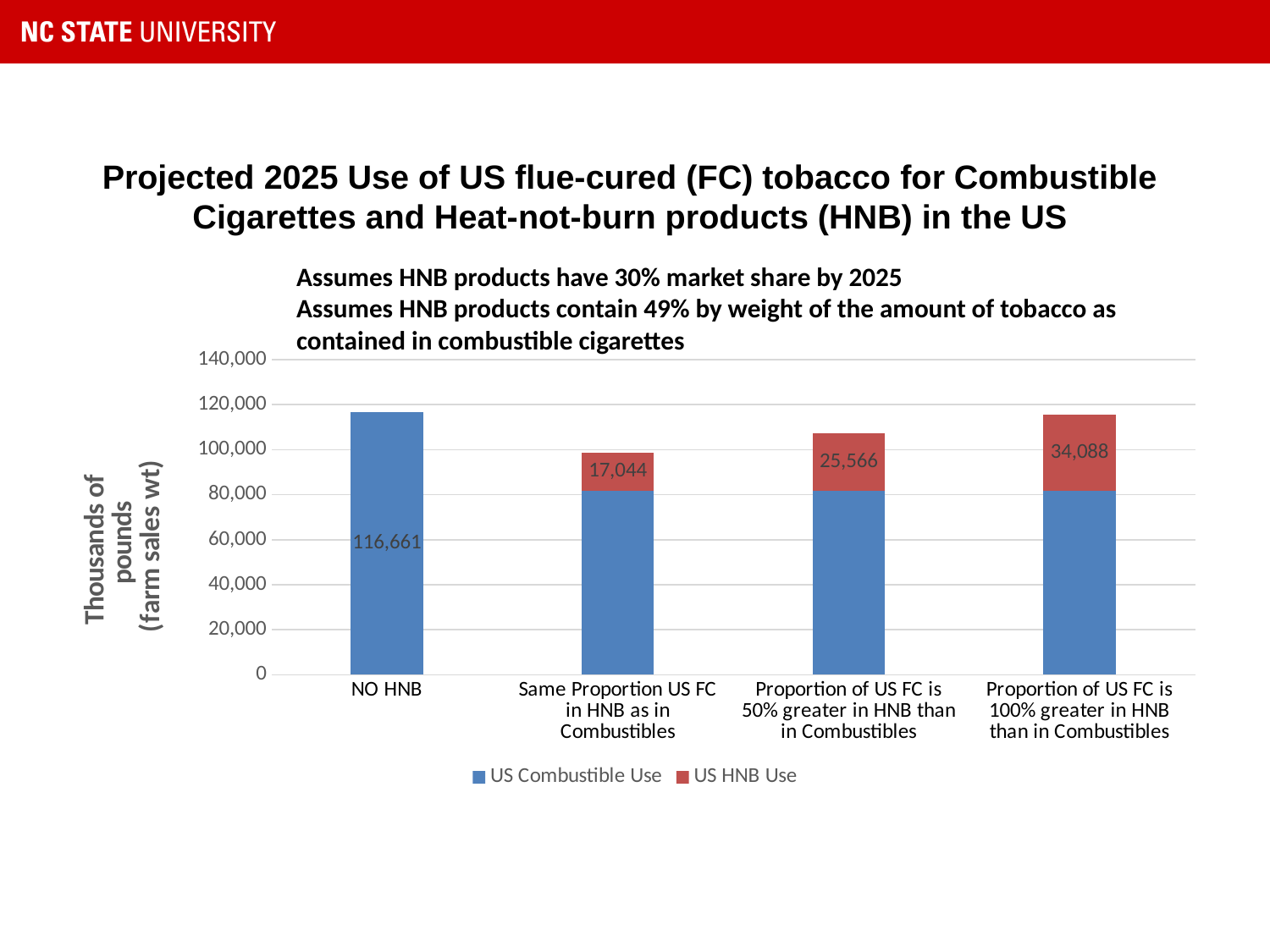
What is the US HNB Use value when the proportion of US FC is 100% greater in HNB than in Combustibles? 34,088 What is the difference between the US HNB Use values for the '100% greater' scenario and the 'Same Proportion' scenario? 17,044 What is the US Combustible Use value for the NO HNB scenario? 116,661 Is the US Combustible Use value for the 'Same Proportion US FC in HNB as in Combustibles' scenario greater or less than 100,000? less How many categories are shown along the x axis of the chart? 4 What is the US HNB Use value for the 'Same Proportion US FC in HNB as in Combustibles' scenario? 17,044 How many series does the chart's legend list? 2 What is the difference between the US HNB Use values for the '50% greater' scenario and the 'Same Proportion' scenario? 8,522 What are the two series named in the chart's legend? US Combustible Use and US HNB Use What is the US HNB Use value when the proportion of US FC is 50% greater in HNB than in Combustibles? 25,566 What kind of chart is shown on the slide? Stacked bar chart Which scenario has the highest US HNB Use value? Proportion of US FC is 100% greater in HNB than in Combustibles